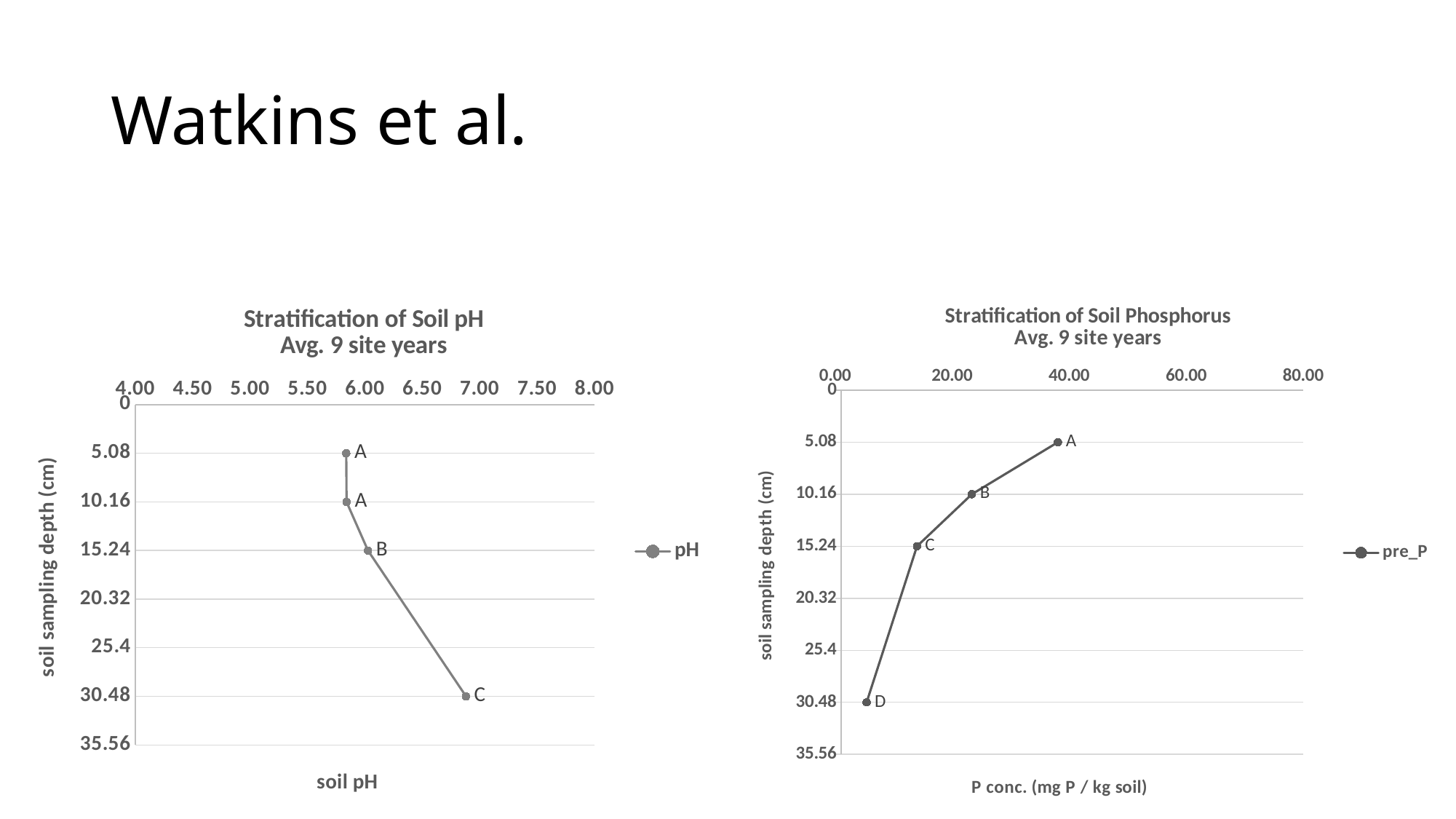
On the Stratification of Soil pH chart, is the pH at depth 5.08 greater or less than 6.00? less On the Stratification of Soil pH chart, at which soil sampling depth is the pH highest? 30.48 On the Stratification of Soil pH chart, what kind of chart is shown? line chart On the Stratification of Soil Phosphorus chart, at which soil sampling depth is the P concentration highest? 5.08 On the Stratification of Soil Phosphorus chart, what is the name of the series in the legend? pre_P On the Stratification of Soil Phosphorus chart, is the P concentration at depth 10.16 greater or less than 20.00? greater On the Stratification of Soil pH chart, does soil pH rise or fall as sampling depth increases? rise On the Stratification of Soil Phosphorus chart, at which soil sampling depth is the P concentration lowest? 30.48 On the Stratification of Soil pH chart, is the pH at depth 30.48 greater or less than 6.50? greater On the Stratification of Soil Phosphorus chart, how many series does the legend list? 1 On the Stratification of Soil pH chart, how many data points are plotted? 4